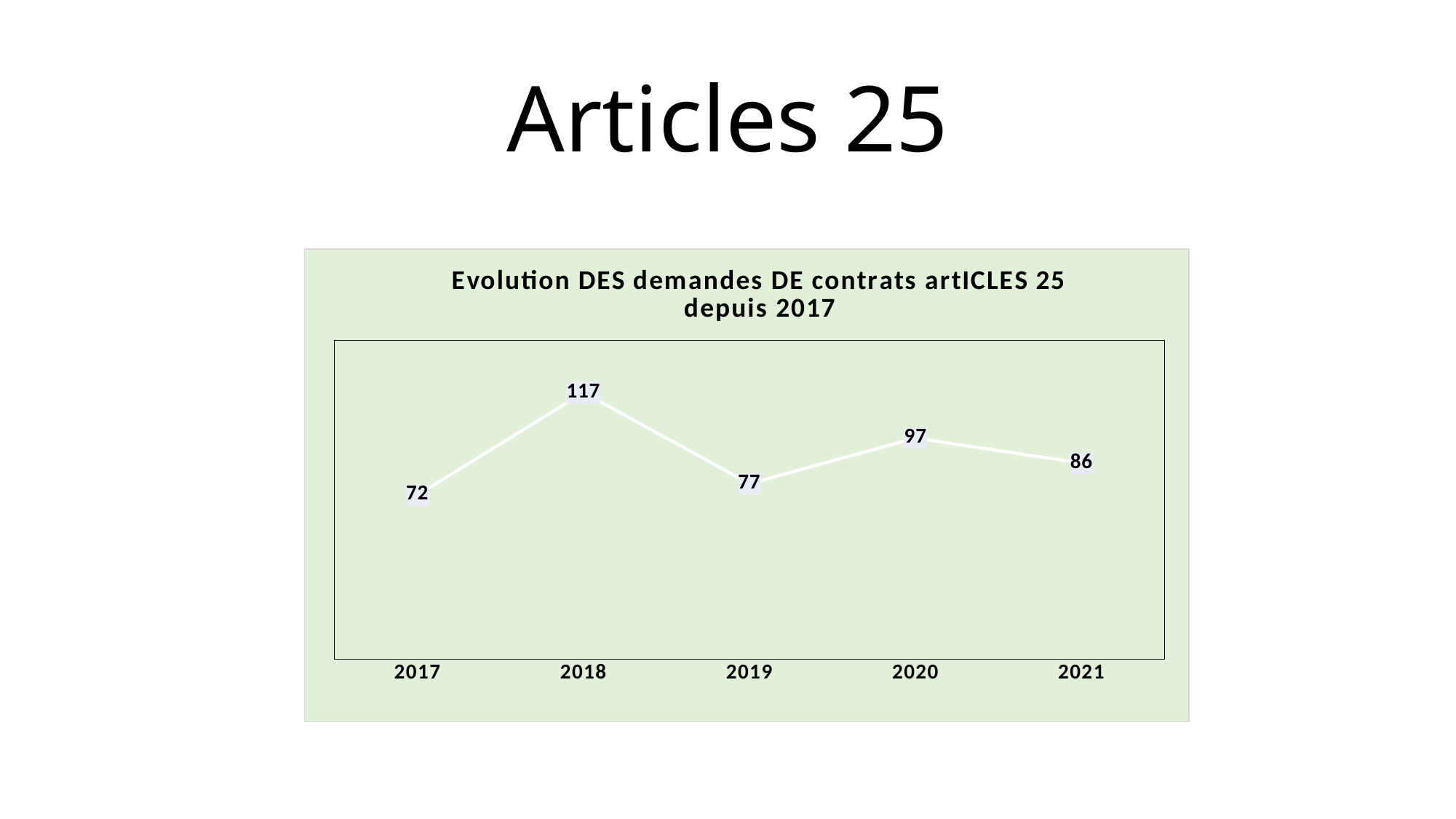
What is the title of the chart? Evolution DES demandes DE contrats artICLES 25 depuis 2017 What is the value for 2018? 117 How many years are plotted on the chart? 5 Which year has the highest value? 2018 What is the value for 2021? 86 Which is larger, the value for 2020 or the value for 2021? 2020 What is the value for 2017? 72 What is the value for 2020? 97 Which year has the lowest value? 2017 What is the value for 2019? 77 What kind of chart is shown on the slide? Line chart What is the difference between the values for 2018 and 2019? 40